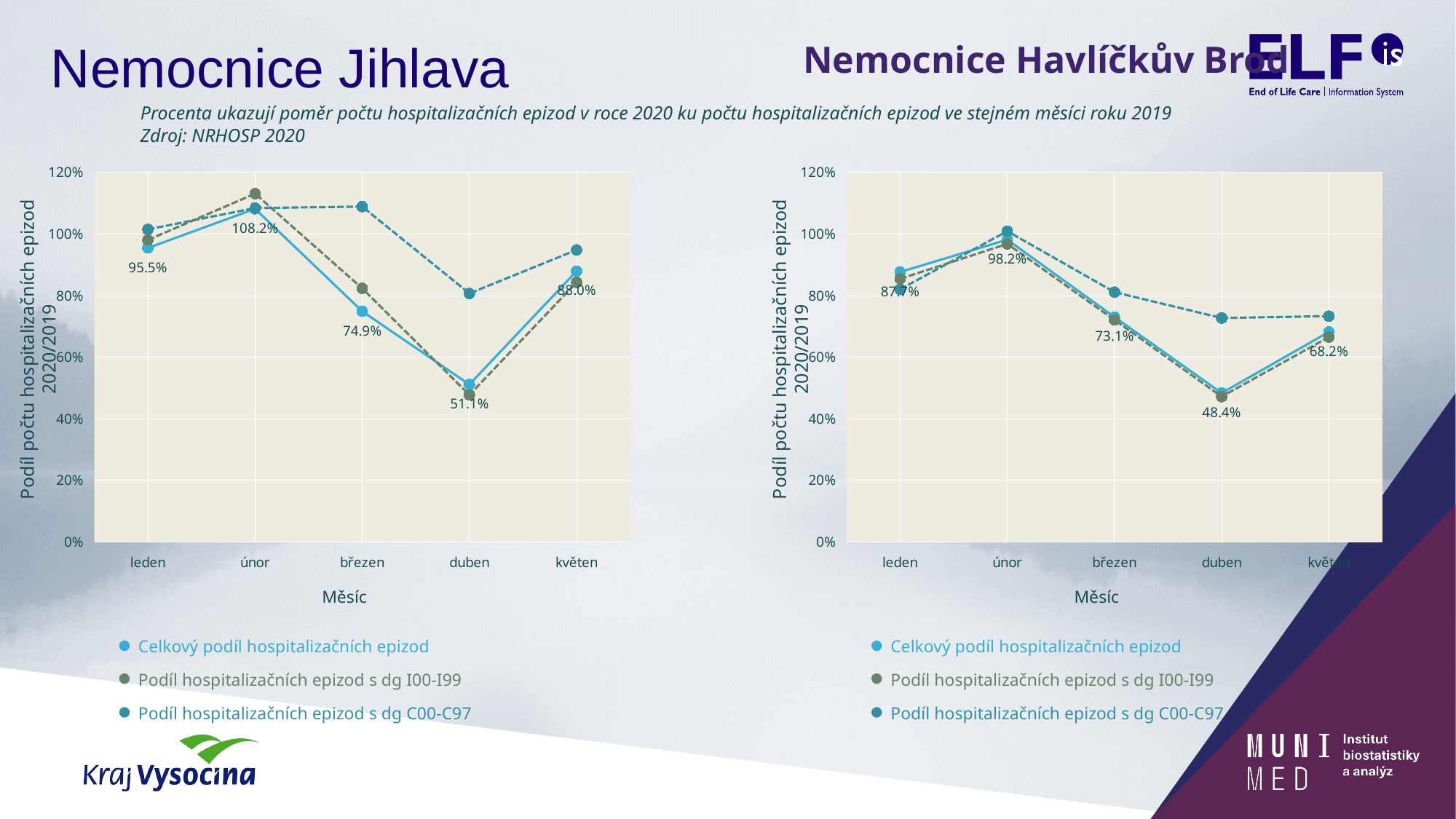
On the Nemocnice Havlíčkův Brod chart, is the value of Podíl hospitalizačních epizod s dg C00-C97 for duben greater or less than 60%? greater On the Nemocnice Havlíčkův Brod chart, which month has the larger Celkový podíl value, leden or květen? leden What kind of chart is the Nemocnice Jihlava chart? line chart On the Nemocnice Jihlava chart, is the value of Podíl hospitalizačních epizod s dg C00-C97 for březen greater or less than 100%? greater On the Nemocnice Jihlava chart, in which month is Celkový podíl hospitalizačních epizod highest? únor On the Nemocnice Havlíčkův Brod chart, does Celkový podíl hospitalizačních epizod rise or fall from únor to duben? fall On the Nemocnice Havlíčkův Brod chart, what is the value of Celkový podíl hospitalizačních epizod for únor? 98.2% How many series does the legend of the Nemocnice Havlíčkův Brod chart list? 3 On the Nemocnice Havlíčkův Brod chart, in which month is Celkový podíl hospitalizačních epizod lowest? duben On the Nemocnice Jihlava chart, what is the value of Celkový podíl hospitalizačních epizod for duben? 51.1% On the Nemocnice Jihlava chart, what is the difference between the Celkový podíl values for únor and březen? 33.3% How many months are shown on the x axis of the Nemocnice Jihlava chart? 5